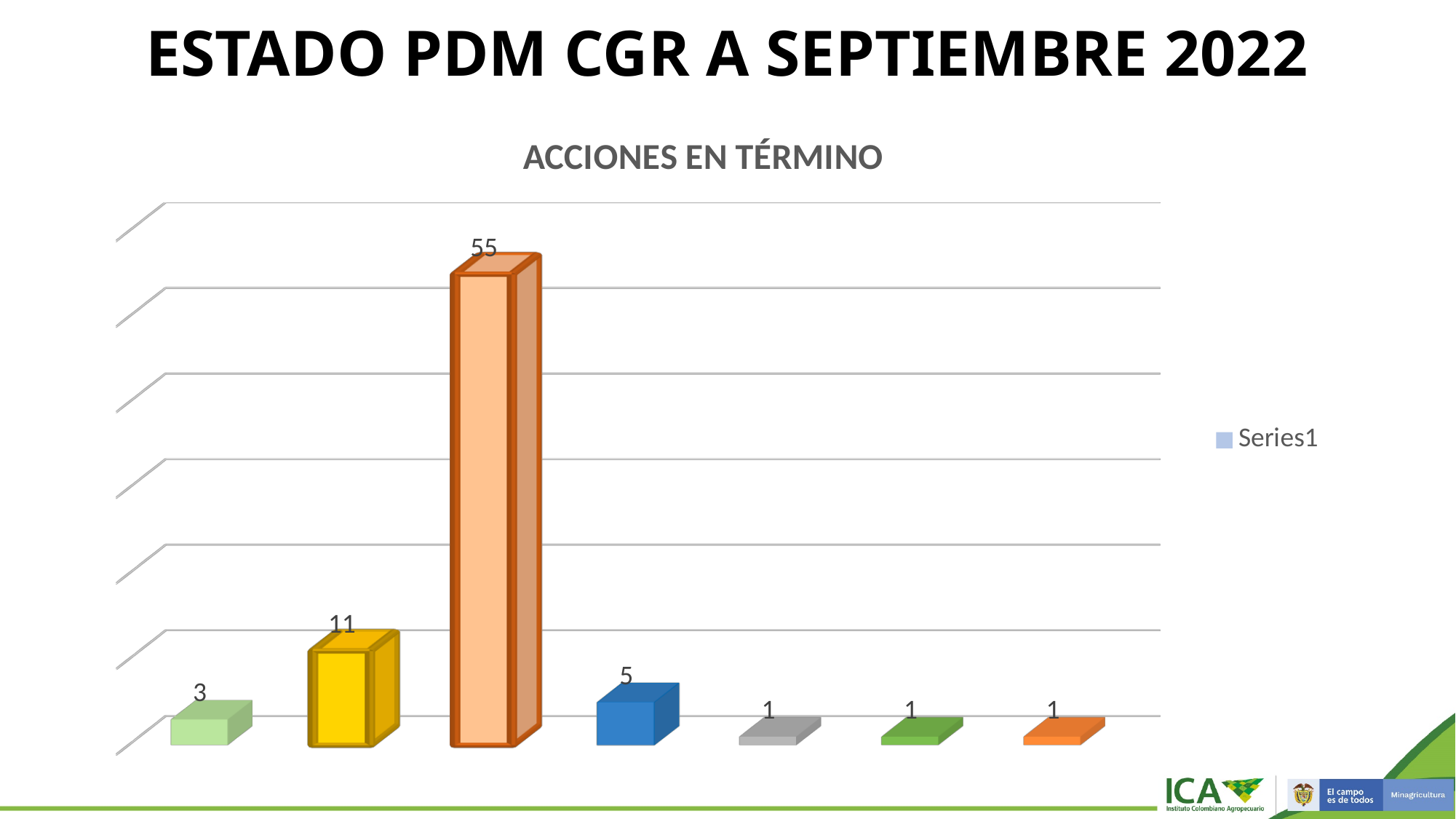
What is the name of the series shown in the legend? Series1 What is the value of the yellow bar (second from the left)? 11 What is the value of the light green bar (first from the left)? 3 What is the difference between the tallest bar (55) and the yellow bar (11)? 44 What is the value of the grey bar (fifth from the left)? 1 What is the value of the tallest bar (the orange bar, third from the left)? 55 What is the title of the chart on the slide? ACCIONES EN TÉRMINO How many series does the legend list? 1 Which is larger, the value of the blue bar or the value of the light green bar? the blue bar What kind of chart is shown on the slide? bar chart What is the value of the blue bar (fourth from the left)? 5 How many bars are plotted in the chart? 7